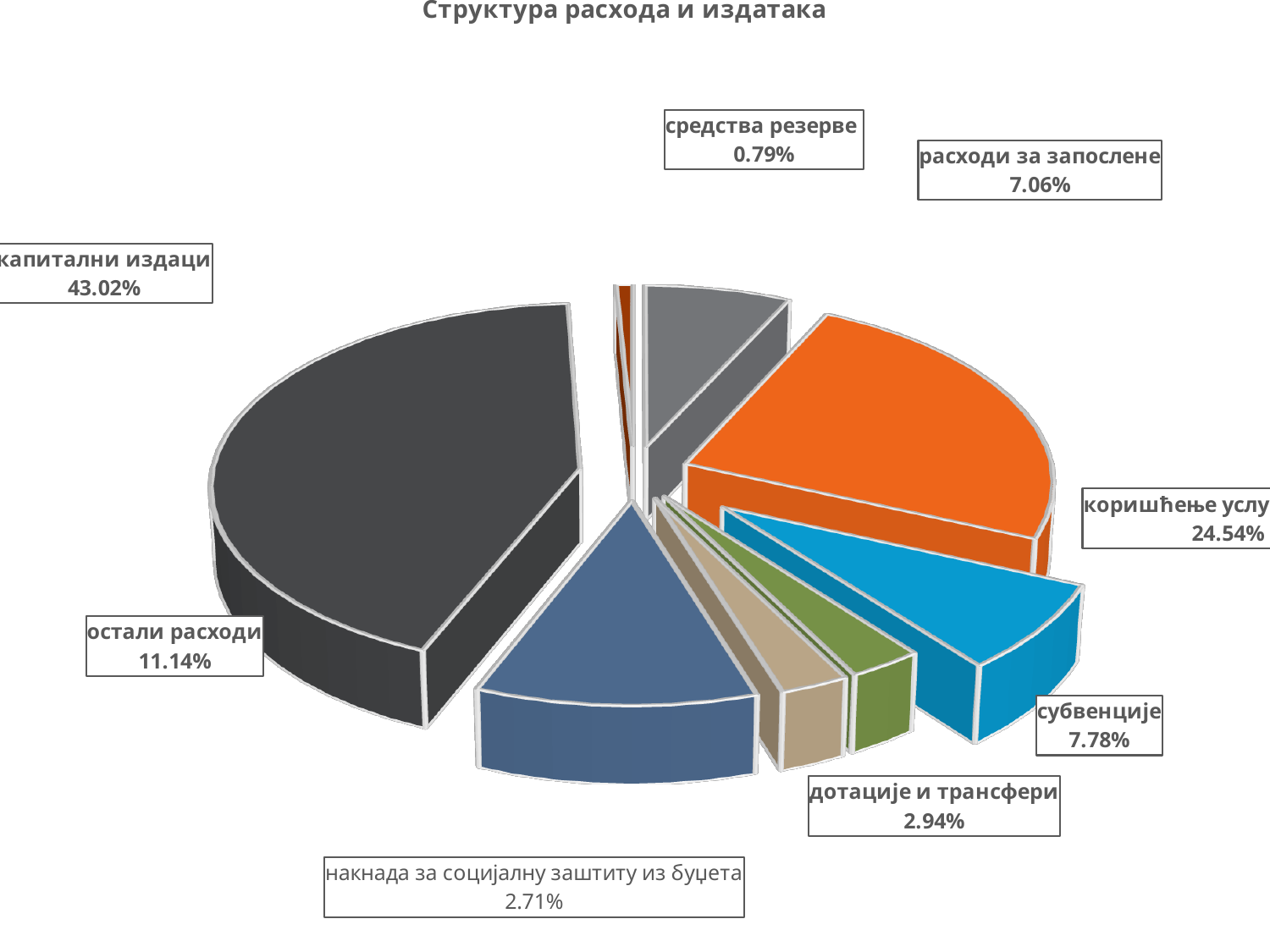
What is the value shown for остали расходи? 11.14% What is the value shown for средства резерве? 0.79% What is the difference in percentage points between субвенције and расходи за запослене? 0.72 percentage points By how many percentage points does капитални издаци exceed остали расходи? 31.88 percentage points What is the value shown for субвенције? 7.78% What share does капитални издаци have in the pie chart? 43.02% Which category has the largest share of the pie? капитални издаци How many slices does the pie chart have? 8 What is the title of the chart? Структура расхода и издатака What kind of chart is shown on the slide? Pie chart Which is larger: дотације и трансфери or накнада за социјалну заштиту из буџета? дотације и трансфери Which category has the smallest share of the pie? средства резерве